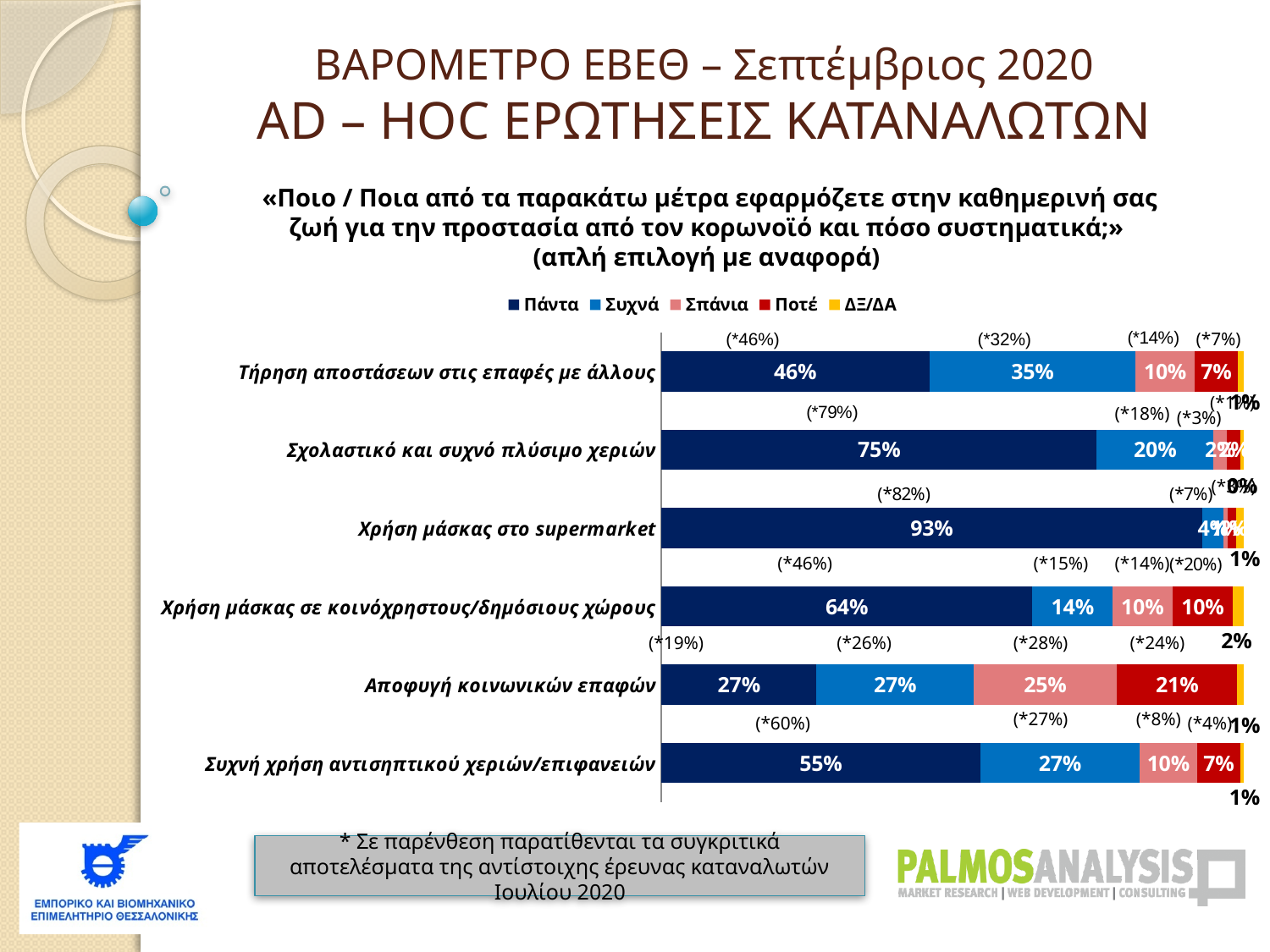
What percentage answered Πάντα for Χρήση μάσκας στο supermarket? 93% How many percentage points higher is the Πάντα value for Σχολαστικό και συχνό πλύσιμο χεριών than for Τήρηση αποστάσεων στις επαφές με άλλους? 29 percentage points Which measure has the highest Πάντα percentage? Χρήση μάσκας στο supermarket What percentage answered Συχνά for Συχνή χρήση αντισηπτικού χεριών/επιφανειών? 27% What kind of chart is shown on the slide? Stacked horizontal bar chart What percentage answered Ποτέ for Αποφυγή κοινωνικών επαφών? 21% Which has the larger Συχνά value: Τήρηση αποστάσεων στις επαφές με άλλους or Συχνή χρήση αντισηπτικού χεριών/επιφανειών? Τήρηση αποστάσεων στις επαφές με άλλους Which measure has the lowest Πάντα percentage? Αποφυγή κοινωνικών επαφών How many series does the legend list? 5 What percentage answered Πάντα for Τήρηση αποστάσεων στις επαφές με άλλους? 46% What percentage answered Σπάνια for Χρήση μάσκας σε κοινόχρηστους/δημόσιους χώρους? 10% How many measures (categories) are shown in the chart? 6